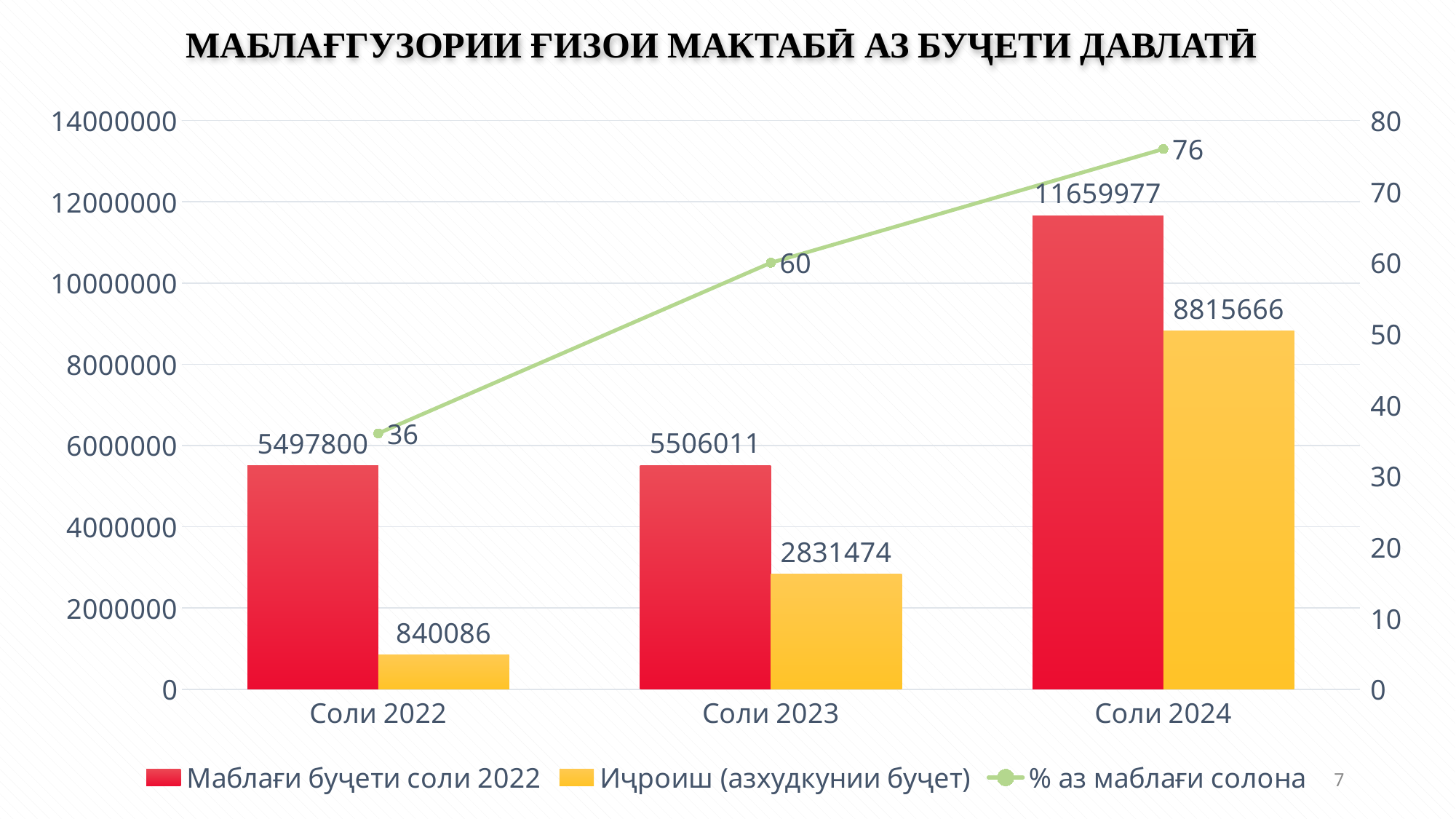
Which is larger: the yellow bar for Соли 2023 or the yellow bar for Соли 2024? Соли 2024 How many year categories are shown on the x axis? 3 What is the value of the red bar (Маблағи буҷети соли 2022) for Соли 2024? 11659977 What is the difference between the red bar and the yellow bar for Соли 2023? 2674537 How many series does the legend list? 3 What value does the line series (% аз маблағи солона) show for Соли 2023? 60 Which year has the lowest value on the % аз маблағи солона line? Соли 2022 What is the difference between the % аз маблағи солона values for Соли 2024 and Соли 2022? 40 What is the value of the yellow bar (Иҷроиш (азхудкунии буҷет)) for Соли 2022? 840086 Which year has the highest value for Иҷроиш (азхудкунии буҷет)? Соли 2024 Is the red bar for Соли 2024 greater or less than 10000000? greater Does the % аз маблағи солона line rise or fall from Соли 2022 to Соли 2024? rise